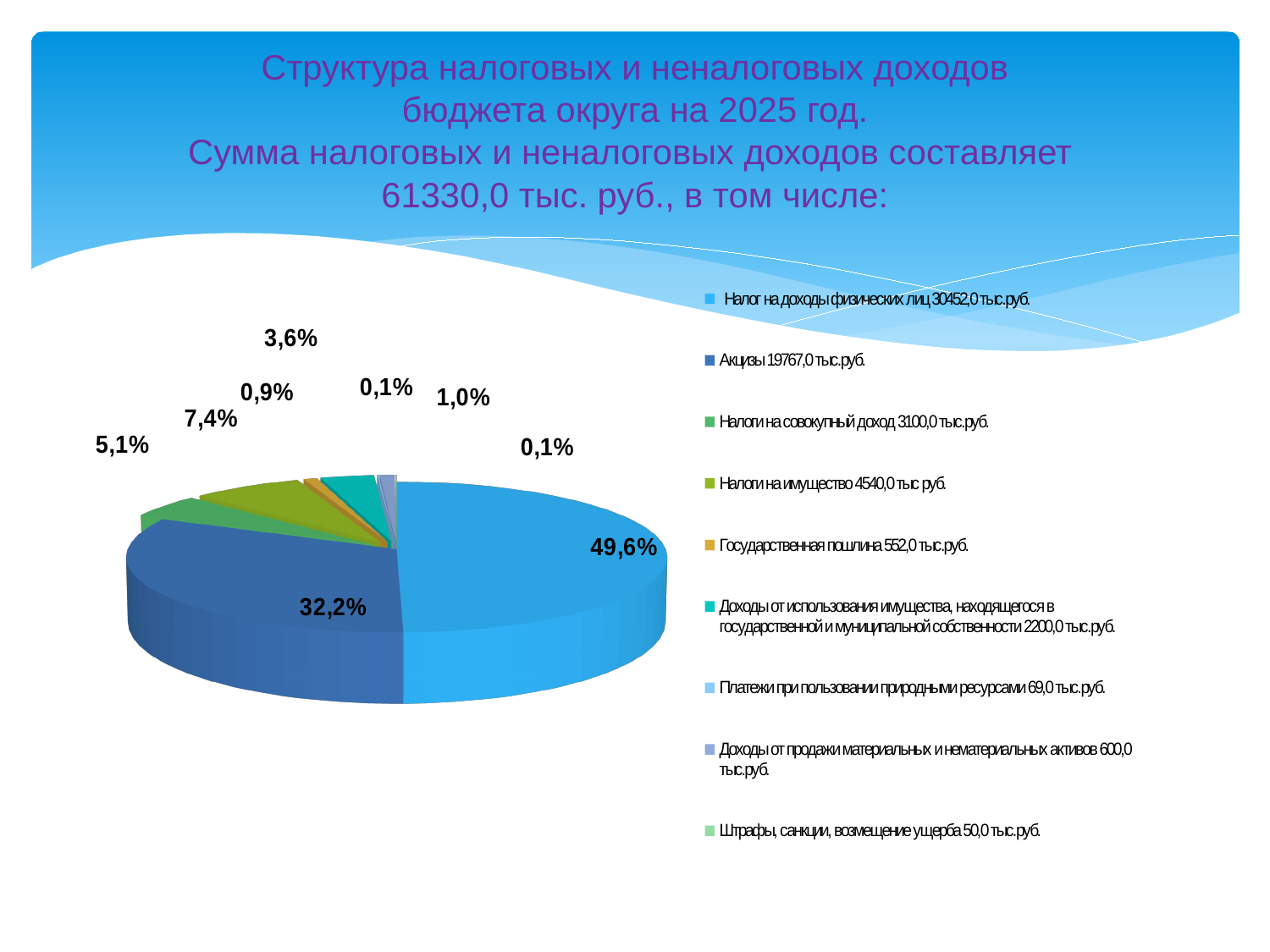
According to the legend, what is the amount for "Акцизы"? 19767,0 тыс.руб. What share of the pie does "Налоги на совокупный доход" account for? 5,1% How many categories does the legend of the pie chart list? 9 What share of the pie does "Налоги на имущество" account for? 7,4% What kind of chart is shown on the slide? pie chart According to the slide title, what is the total sum of tax and non-tax revenues? 61330,0 тыс. руб. What is the difference in percentage points between the share for "Налог на доходы физических лиц" and the share for "Акцизы"? 17,4% According to the legend, what is the amount for "Государственная пошлина"? 552,0 тыс.руб. Which category has the largest slice of the pie? Налог на доходы физических лиц What share of the pie does "Акцизы" account for? 32,2% Which is larger: the share for "Акцизы" or the share for "Налоги на имущество"? Акцизы